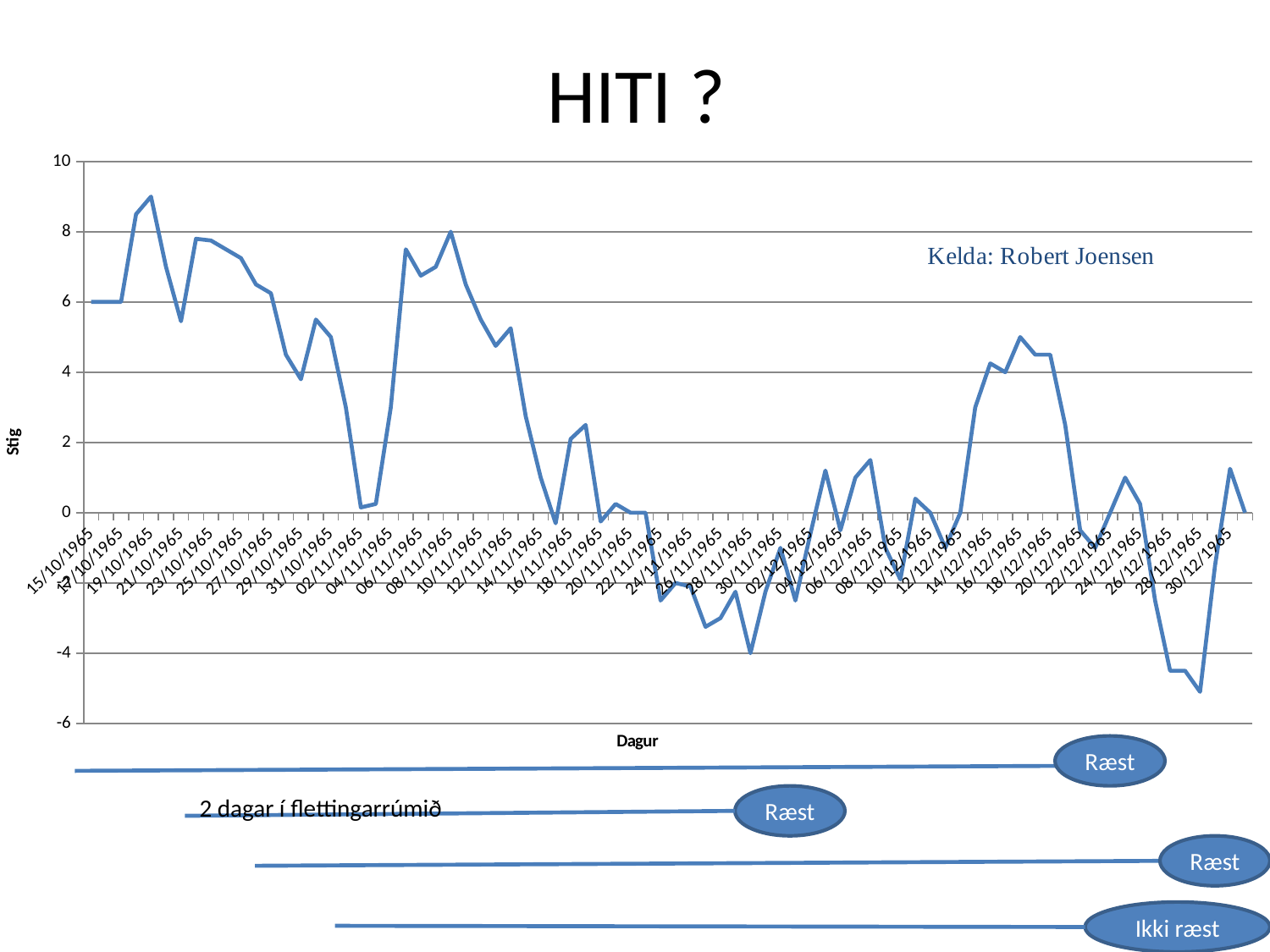
Is the value for 15/10/1965 greater or less than 4? greater Is the value for 28/12/1965 greater or less than -2? less What is the label on the vertical axis of the chart? Stig Is the value for 10/11/1965 greater or less than 6? less What is the title of the chart? HITI ? What kind of chart is shown on the slide? line chart Which is larger, the value for 15/10/1965 or the value for 30/12/1965? 15/10/1965 Overall, do the values rise or fall from the start of the x axis to the end? fall